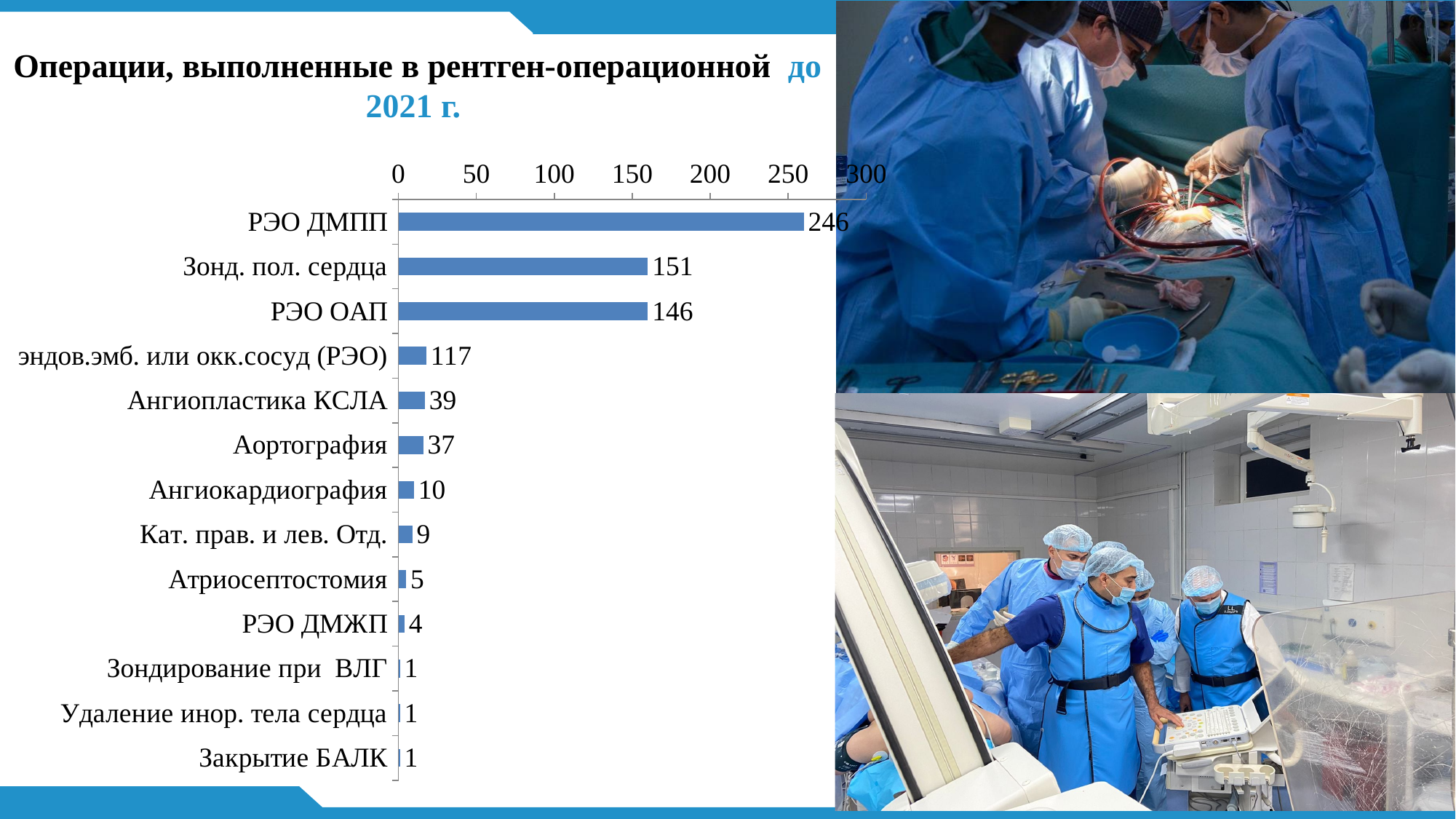
What is the difference between the values for РЭО ДМПП and Зонд. пол. сердца? 95 Is the value for РЭО ДМПП greater or less than 200? greater What is the value for Аортография? 37 What is the value for Атриосептостомия? 5 What is the difference between the values for Ангиопластика КСЛА and Аортография? 2 What kind of chart is shown on the slide? bar chart What is the value for Зонд. пол. сердца? 151 Which is larger, the value for Зонд. пол. сердца or the value for РЭО ОАП? Зонд. пол. сердца How many categories are shown in the chart? 13 What is the title of the chart? Операции, выполненные в рентген-операционной до 2021 г. Which category has the highest value? РЭО ДМПП What is the value for РЭО ДМПП? 246